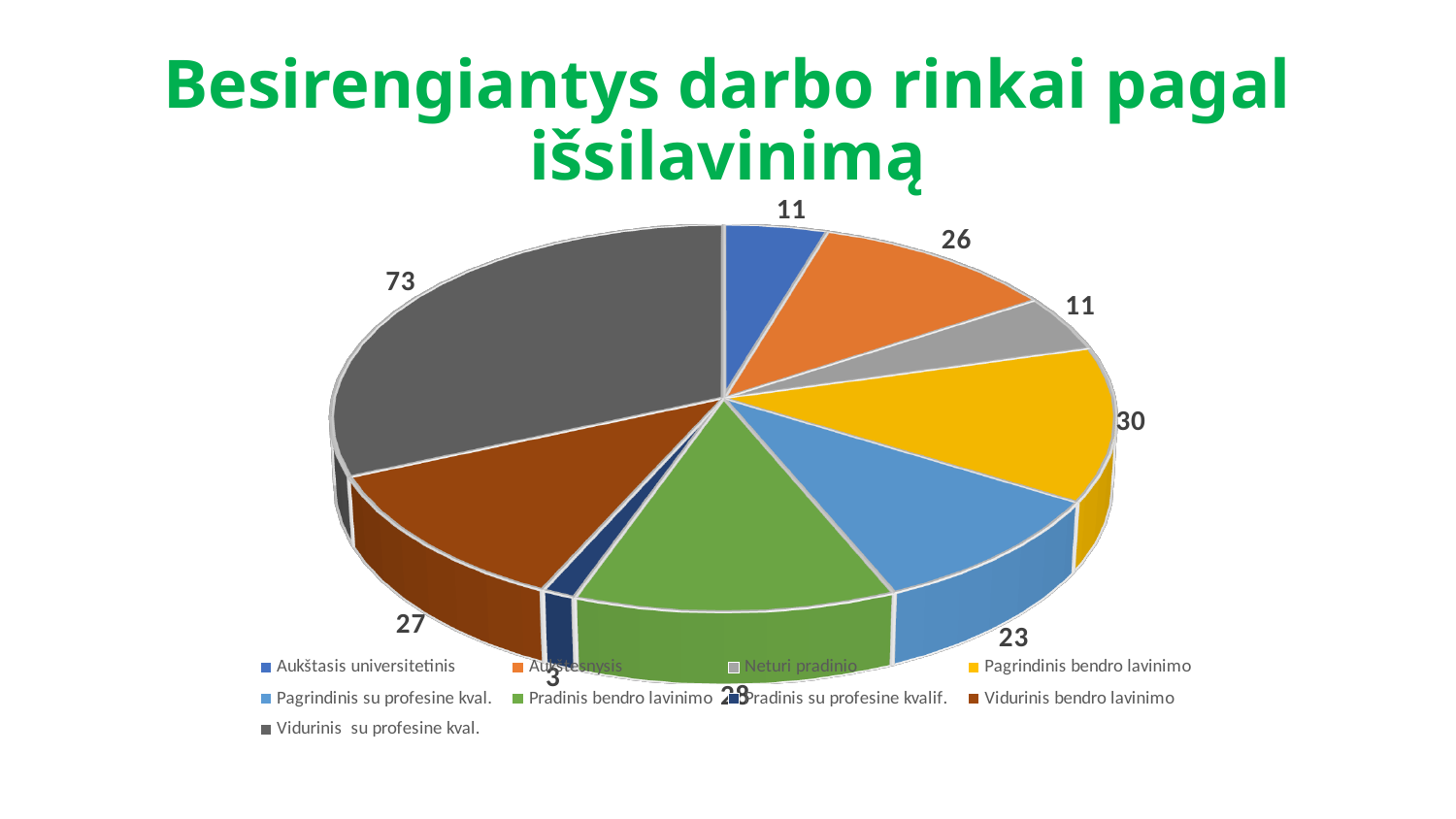
What is the value for Aukštesnysis? 26 What is the value for Pagrindinis bendro lavinimo? 30 How many categories does the pie chart show? 9 What is the title of the chart? Besirengiantys darbo rinkai pagal išsilavinimą Which is larger, the value for Aukštesnysis or the value for Pagrindinis su profesine kval.? Aukštesnysis What is the difference between the values for Vidurinis su profesine kval. and Pagrindinis bendro lavinimo? 43 What is the value for Vidurinis su profesine kval.? 73 What kind of chart is shown on the slide? pie chart What is the value for Pagrindinis su profesine kval.? 23 Which category has the largest slice of the pie? Vidurinis su profesine kval. Which category has the smallest slice of the pie? Pradinis su profesine kvalif. What is the value for Vidurinis bendro lavinimo? 27